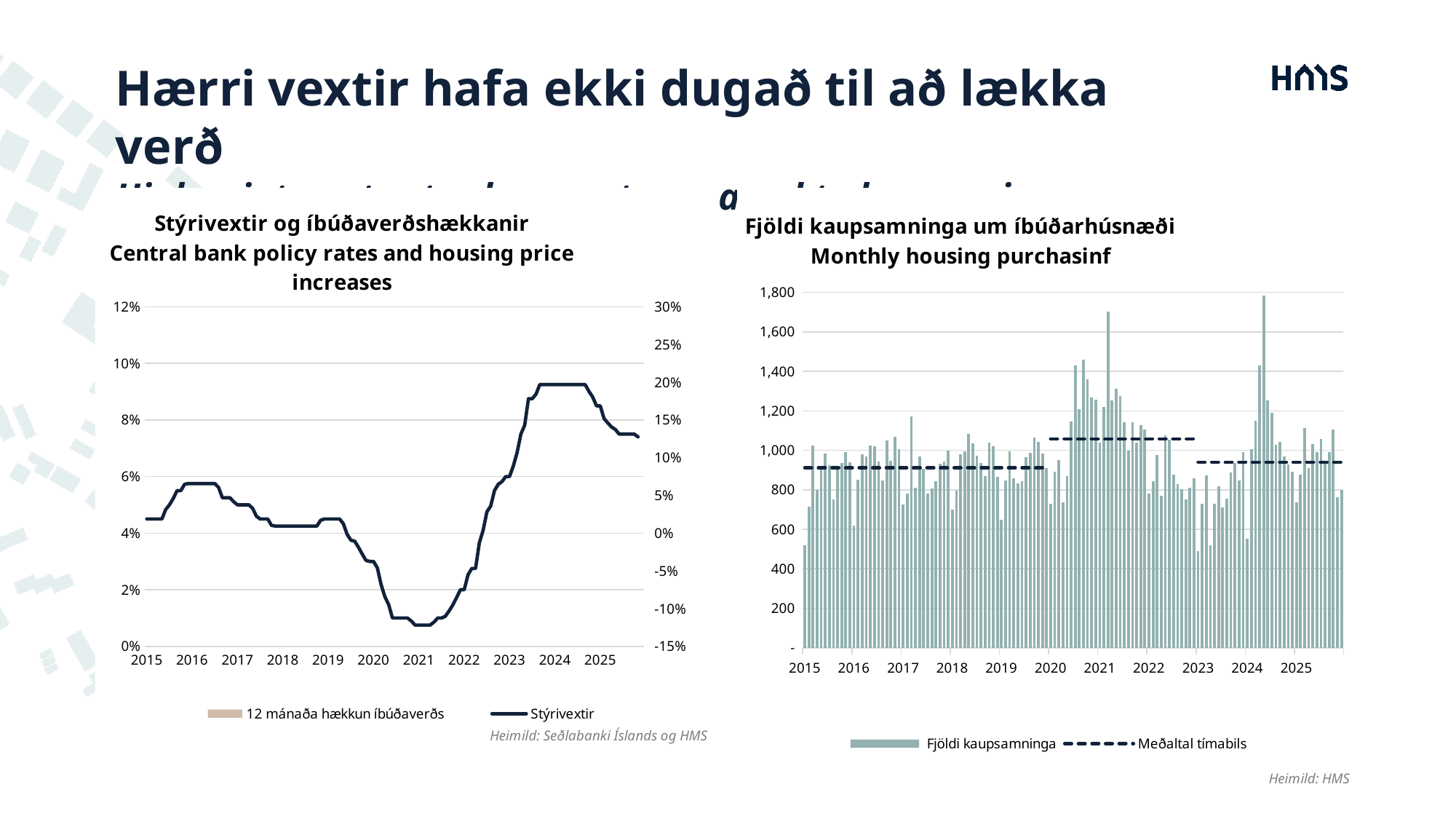
In the left-hand chart, is the peak value of the Stýrivextir line in 2024 greater or less than 8%? greater In the right-hand chart, in which year does the tallest bar occur? 2024 What does the dashed line in the right-hand chart represent, according to the legend? Meðaltal tímabils How many series does the legend of the right-hand chart list? 2 In the left-hand chart, does the Stýrivextir line rise or fall between 2021 and 2024? rise How many series does the legend of the left-hand chart list? 2 In the left-hand chart, does the Stýrivextir line rise or fall from 2024 to the end of 2025? fall What kind of chart is the right-hand chart, 'Fjöldi kaupsamninga um íbúðarhúsnæði'? bar chart In the left-hand chart, is the lowest value of the Stýrivextir line in 2021 greater or less than 2%? less What kind of chart is used for the 'Stýrivextir' series in the left-hand chart? line chart What is the English subtitle of the left-hand chart? Central bank policy rates and housing price increases In the right-hand chart, is the tallest bar greater or less than 1,600? greater